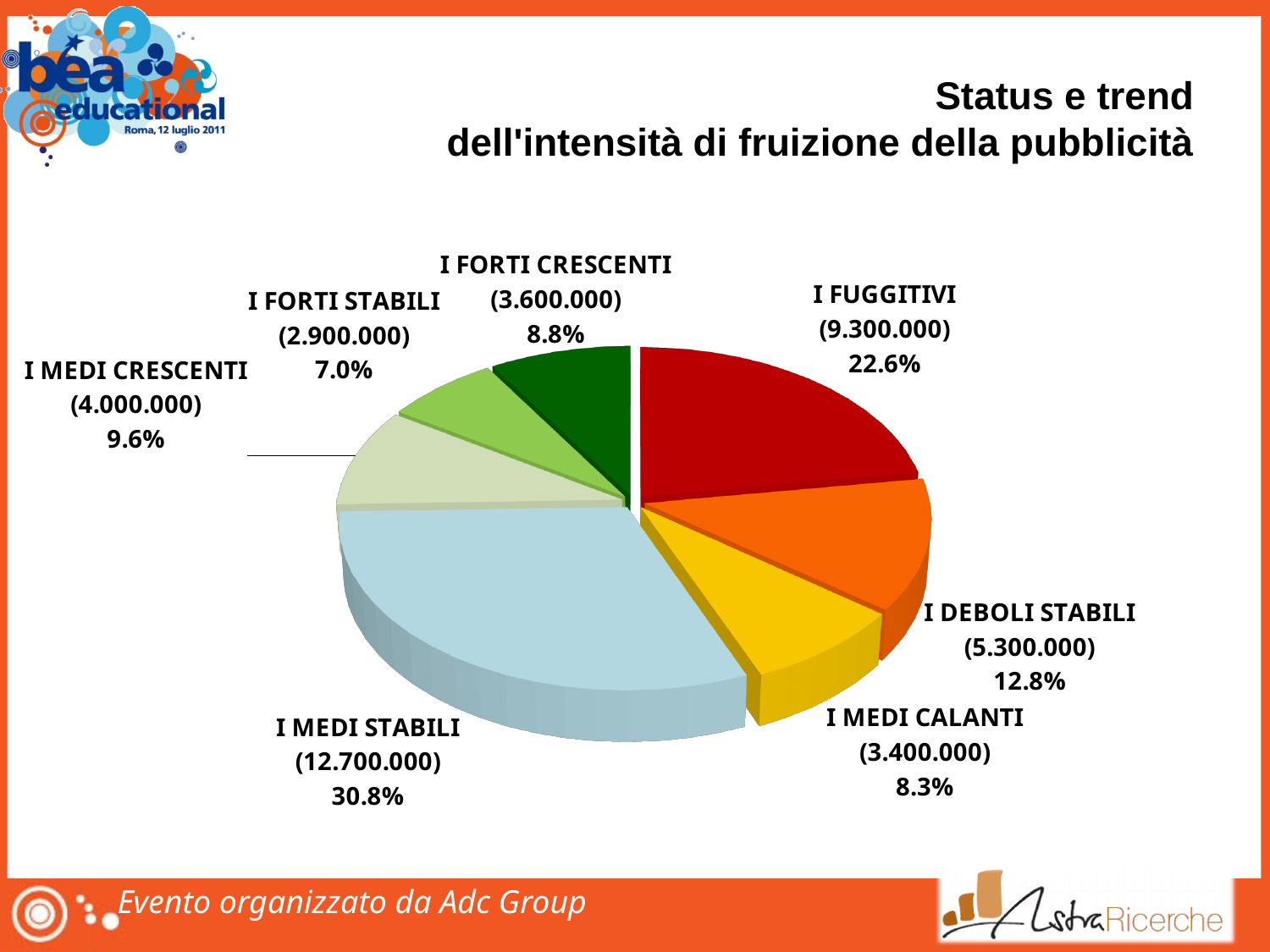
What is the difference in percentage points between I FUGGITIVI and I DEBOLI STABILI? 9.8 What is the title of the slide containing the pie chart? Status e trend dell'intensità di fruizione della pubblicità Which category has the smallest share of the pie? I FORTI STABILI What kind of chart is shown on the slide? pie chart What percentage share is shown for I DEBOLI STABILI? 12.8% What percentage share is shown for I FUGGITIVI? 22.6% What value in parentheses is shown for I FORTI CRESCENTI? 3.600.000 What is the difference in percentage points between I MEDI STABILI and I FUGGITIVI? 8.2 Which category has the largest share of the pie? I MEDI STABILI How many slices does the pie chart have? 7 Which has a larger share, I MEDI CRESCENTI or I MEDI CALANTI? I MEDI CRESCENTI What value in parentheses is shown for I MEDI STABILI? 12.700.000